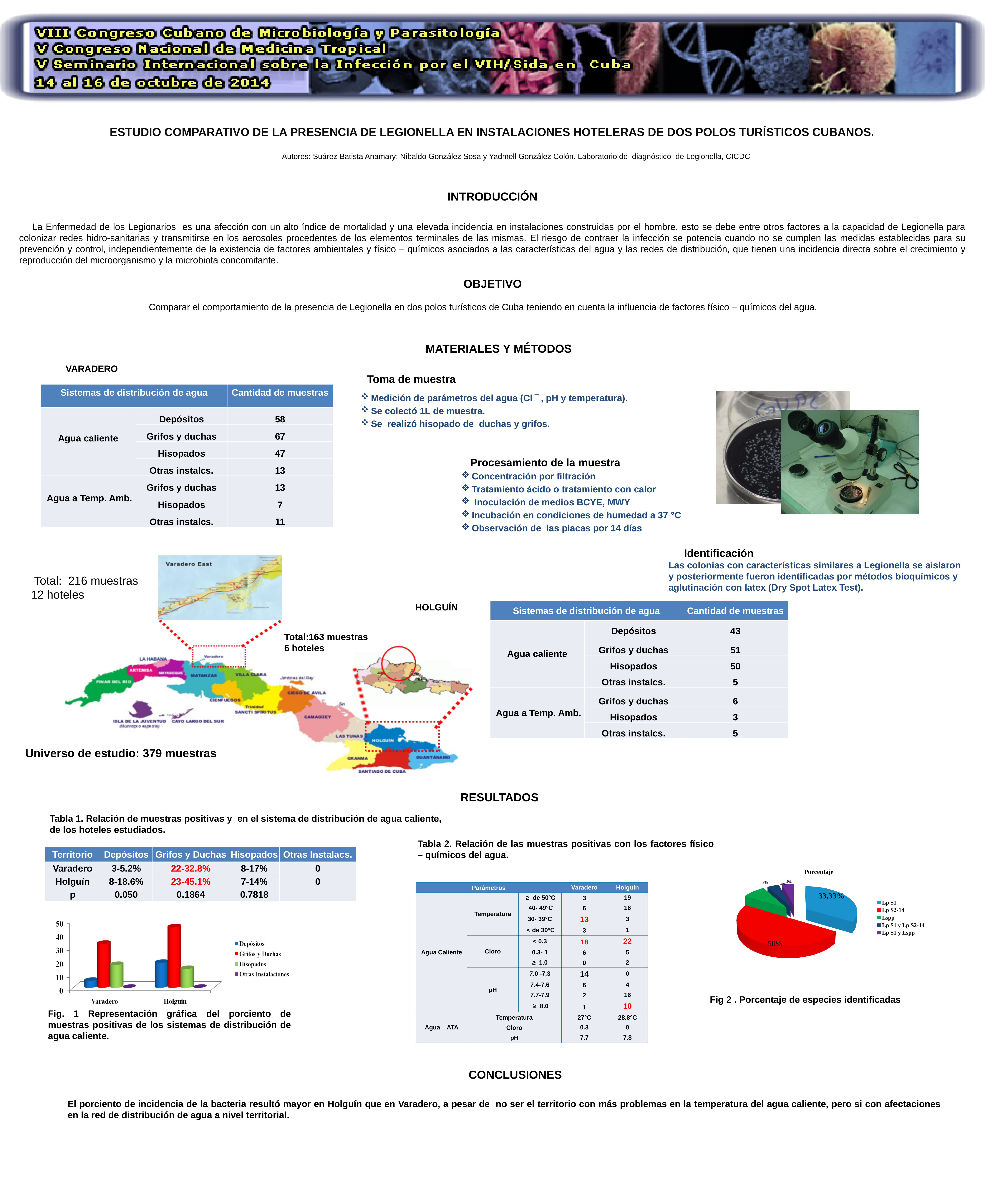
What kind of chart is Fig. 1 (the chart on the left, below Tabla 1)? bar chart In Fig 2 (the pie chart), what share does Lp S1 have? 33,33% In Fig. 1 (the bar chart), which series has the highest bar for Holguín? Grifos y Duchas In Fig. 1 (the bar chart), how many territories are shown on the x axis? 2 In Fig. 1 (the bar chart), which series has the lowest bar for Varadero? Otras Instalaciones In Fig. 1 (the bar chart), is the value for Hisopados in Varadero greater or less than 10? greater In Fig. 1 (the bar chart), is the value for Grifos y Duchas in Holguín greater or less than 40? greater In Fig. 1 (the bar chart), how many series does the legend list? 4 In Fig 2 (the pie chart), what share does Lp S2-14 have? 50% In Fig. 1 (the bar chart), is the Grifos y Duchas bar larger for Varadero or for Holguín? Holguín In Fig. 1 (the bar chart), is the value for Depósitos in Varadero greater or less than 10? less What kind of chart is Fig 2 (Porcentaje de especies identificadas)? pie chart